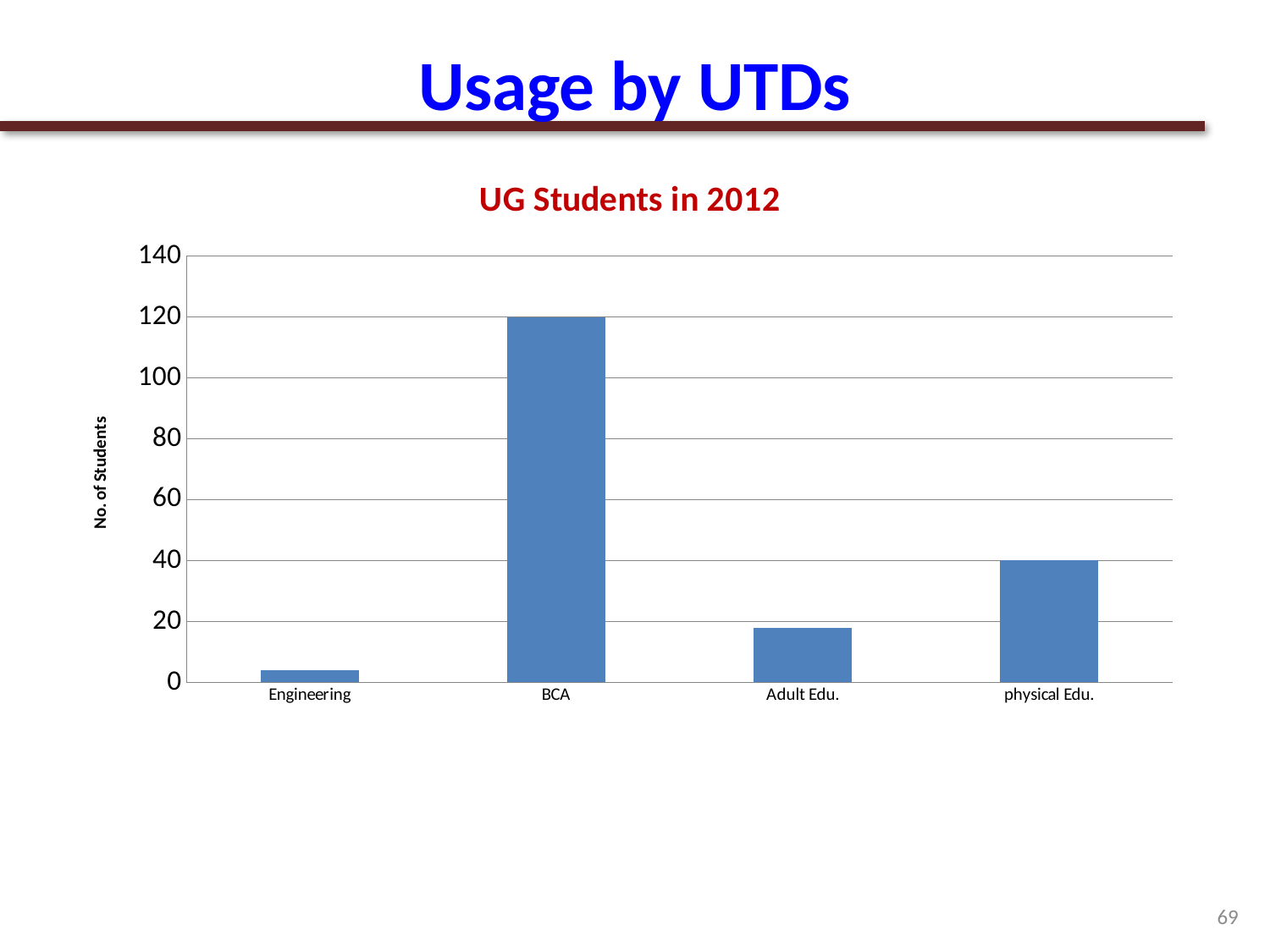
What kind of chart is shown on the slide? bar chart Is the value for Adult Edu. greater or less than 40? less Which has more students, Adult Edu. or physical Edu.? physical Edu. What is the number of students for physical Edu.? 40 Is the value for Engineering greater or less than 20? less What is the title of the chart? UG Students in 2012 What is the label of the y axis? No. of Students How many categories are shown on the x axis of the chart? 4 Which category has the lowest number of students? Engineering Which category has the highest number of students? BCA What is the difference between the number of students for BCA and for physical Edu.? 80 What is the number of students for BCA? 120